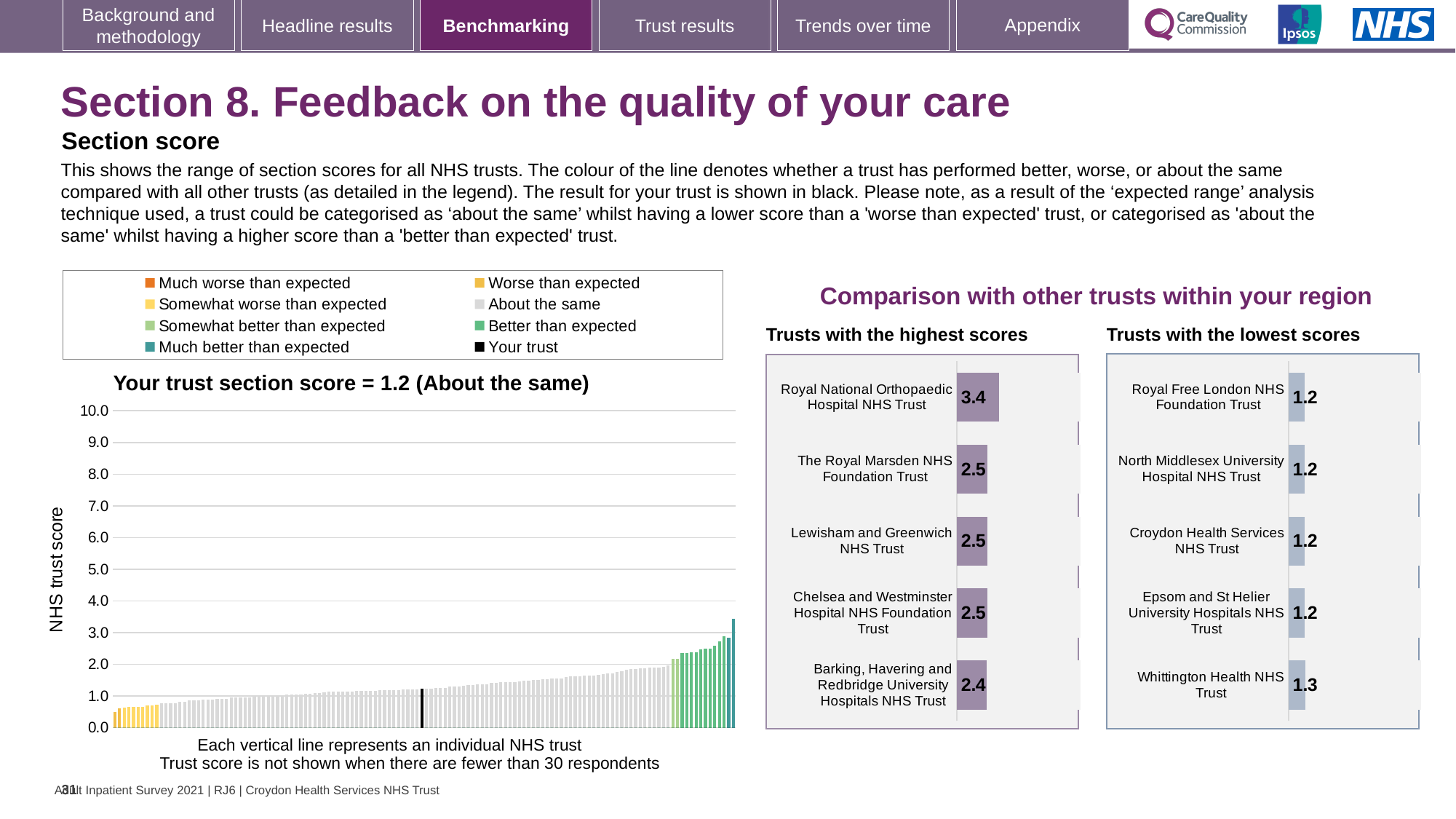
In the 'Trusts with the lowest scores' chart, which has the larger score: Whittington Health NHS Trust or Croydon Health Services NHS Trust? Whittington Health NHS Trust In the 'Trusts with the highest scores' chart, what is the difference between the scores of Royal National Orthopaedic Hospital NHS Trust and Barking, Havering and Redbridge University Hospitals NHS Trust? 1.0 In the 'Trusts with the lowest scores' chart, which trust has the highest score? Whittington Health NHS Trust In the 'Your trust section score' chart, do the bars rise or fall from left to right? rise In the 'Your trust section score' chart, is the value of the tallest bar greater or less than 3.0? greater How many entries does the legend above the 'Your trust section score' chart list? 8 What kind of chart is the 'Your trust section score' chart? bar chart In the 'Trusts with the highest scores' chart, which trust has the lowest score? Barking, Havering and Redbridge University Hospitals NHS Trust In the 'Your trust section score' chart, what is the section score for your trust? 1.2 What is the y-axis label of the 'Your trust section score' chart? NHS trust score In the 'Trusts with the highest scores' chart, what is the score for Royal National Orthopaedic Hospital NHS Trust? 3.4 How many trusts are shown in the 'Trusts with the highest scores' chart? 5